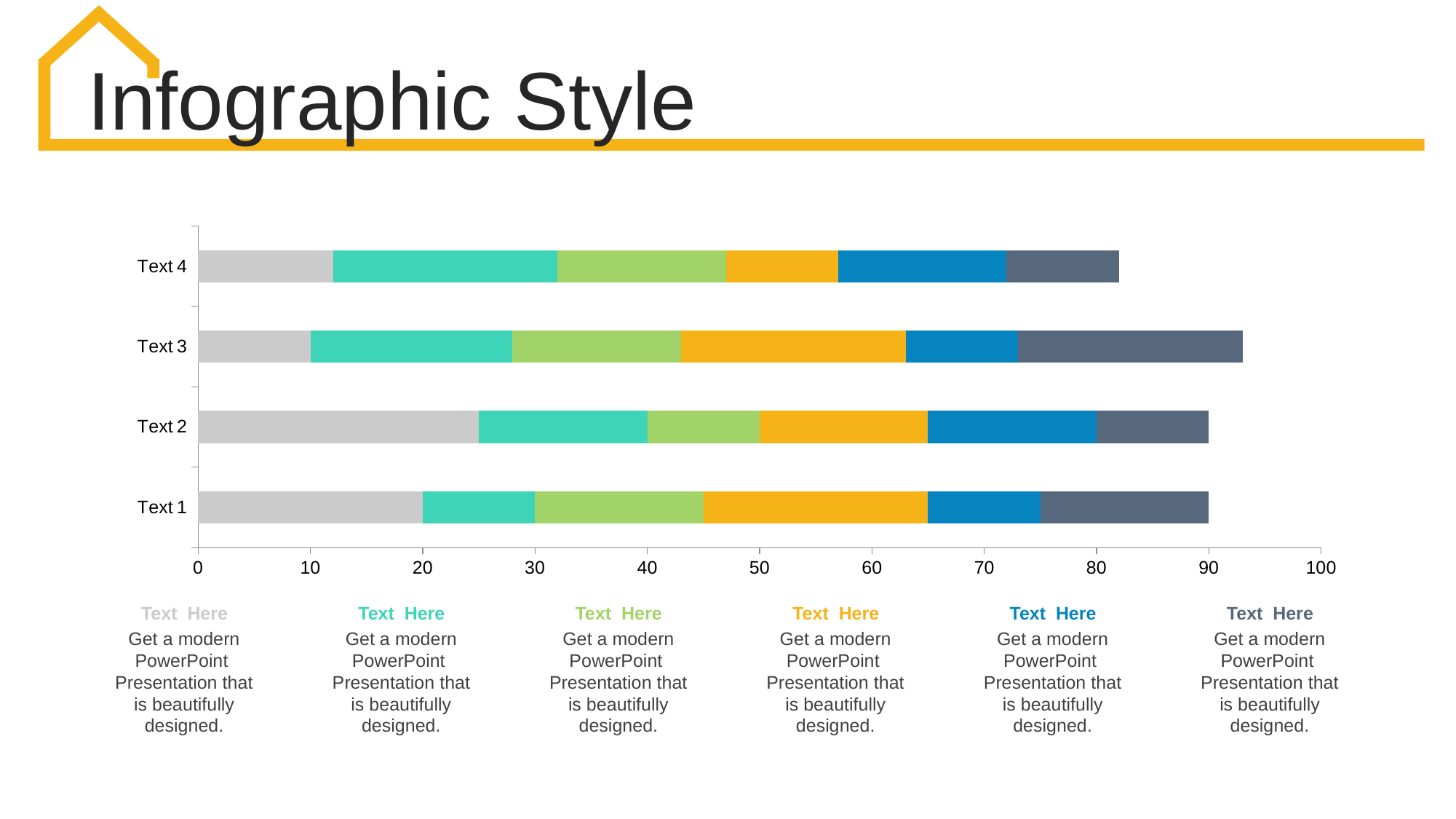
Which category has the shortest total bar? Text 4 What is the value of the first (grey) segment of the Text 1 bar? 20 What kind of chart is shown on the slide? stacked bar chart How many categories are plotted on the chart? 4 Is the total bar length for Text 3 greater or less than 90? greater Which category has the longest total bar? Text 3 Is the total bar length for Text 4 greater or less than 90? less Which has the larger grey segment, Text 1 or Text 2? Text 2 How many coloured segments (series) make up each bar? 6 What is the total length of the bar for Text 1? 90 What is the value of the first (grey) segment of the Text 3 bar? 10 What is the highest value shown on the horizontal axis? 100